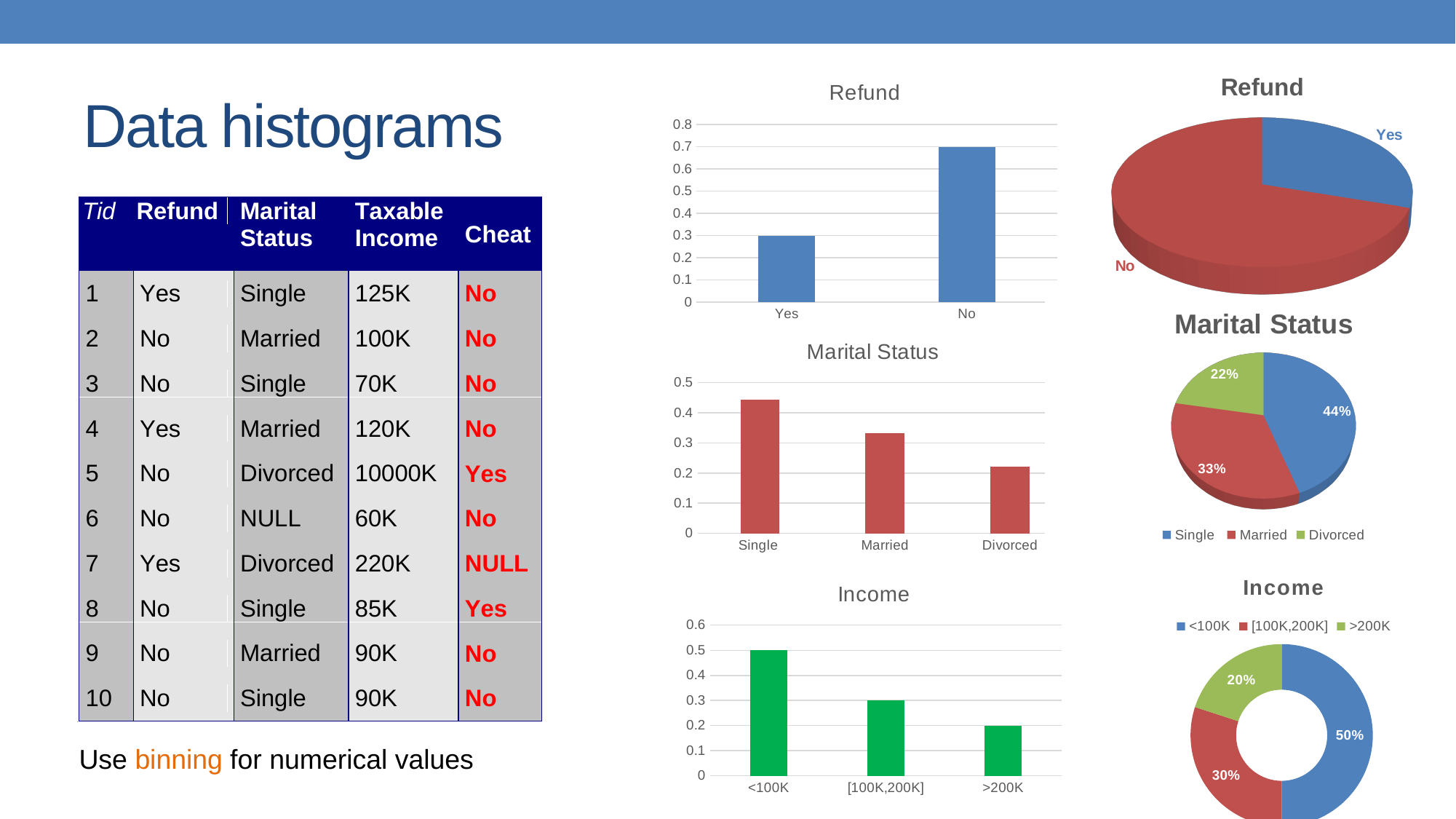
In the Marital Status bar chart, how many categories are shown on the x axis? 3 In the Income bar chart, what is the value for <100K? 0.5 In the Refund bar chart, what is the value for Yes? 0.3 In the Refund bar chart, what is the value for No? 0.7 In the Marital Status pie chart, what share does Married have? 33% In the Income bar chart, what is the difference between the values for <100K and >200K? 0.3 In the Refund bar chart, which category has the higher bar? No What kind of chart is the Income chart on the bottom right of the slide? Donut chart In the Marital Status pie chart, what share does Divorced have? 22% In the Income donut chart, what share does [100K,200K] have? 30% In the Marital Status bar chart, is the value for Single greater or less than 0.4? greater In the Marital Status bar chart, which category has the lowest value? Divorced